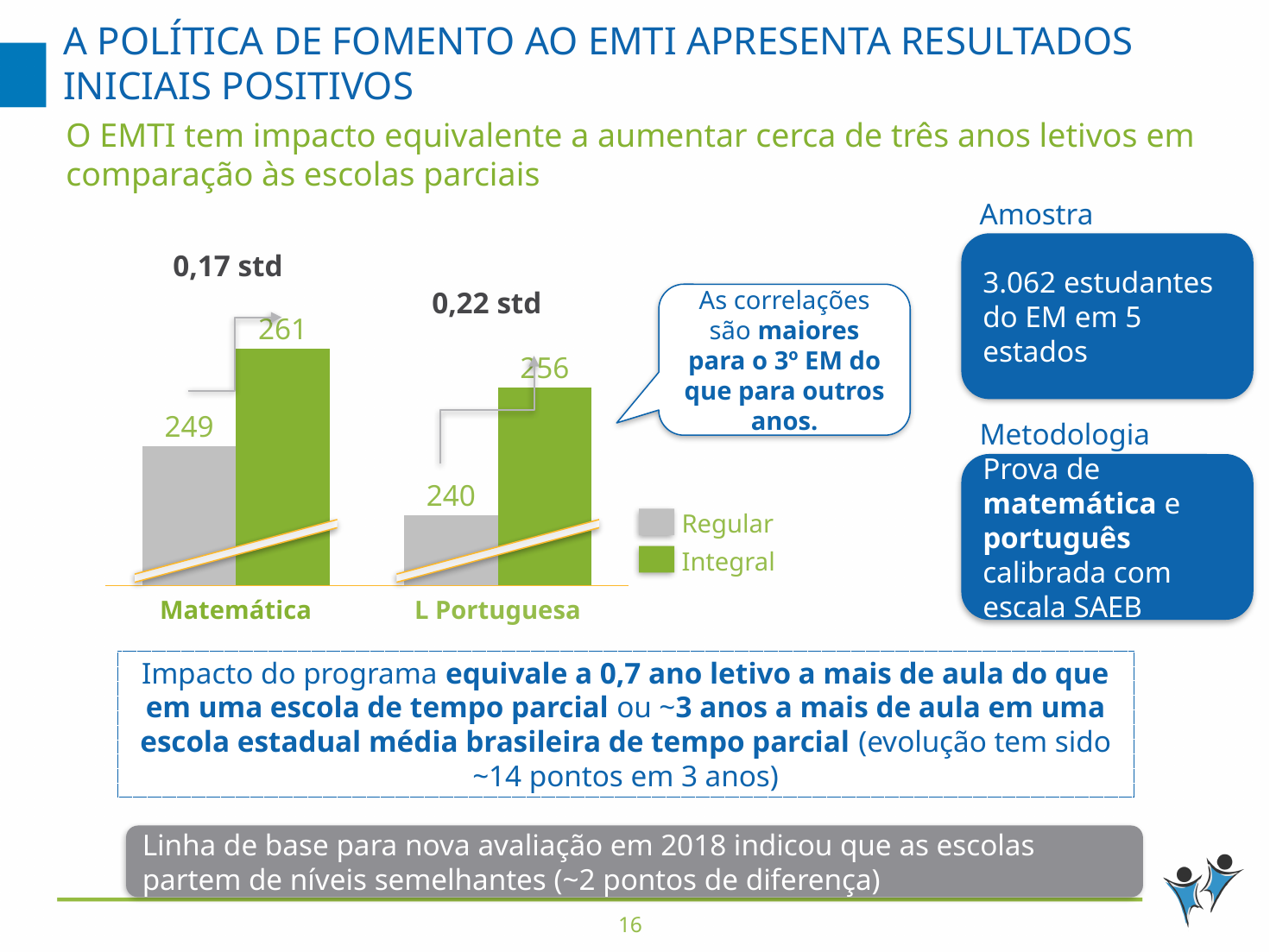
What kind of chart is shown on the slide? Bar chart What is the Regular value for Matemática? 249 What is the Integral value for L Portuguesa? 256 Which is larger, the Regular value for Matemática or the Regular value for L Portuguesa? Matemática What is the Regular value for L Portuguesa? 240 Which bar has the highest value in the chart? Integral, Matemática What standard-deviation effect is labelled above the L Portuguesa bars? 0,22 std Which bar has the lowest value in the chart? Regular, L Portuguesa What is the difference between the Integral and Regular values for Matemática? 12 What is the Integral value for Matemática? 261 What is the difference between the Integral and Regular values for L Portuguesa? 16 How many series does the legend list? 2